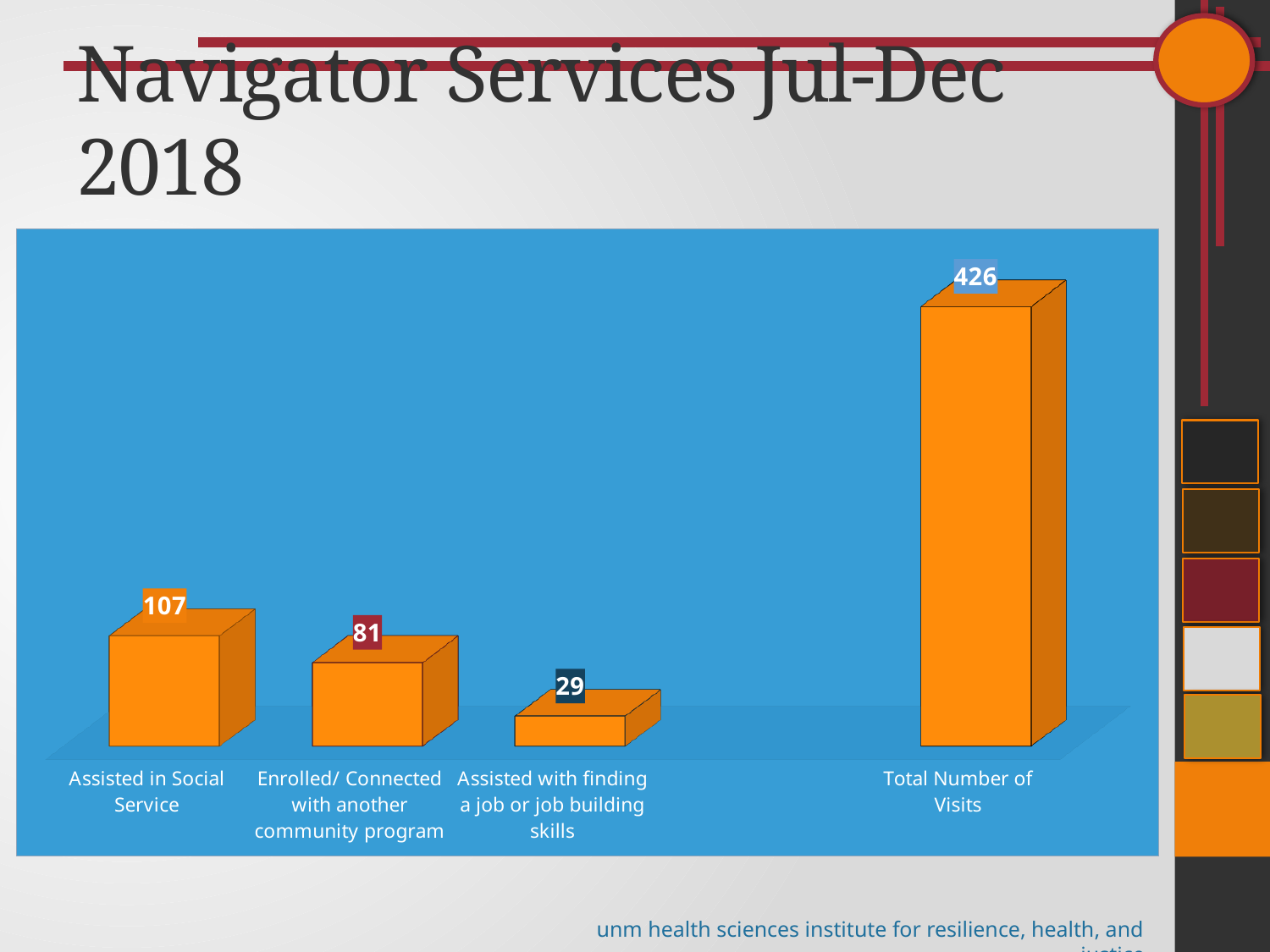
How many categories are shown in the chart? 4 What is the value for Enrolled/ Connected with another community program? 81 What is the value for Assisted in Social Service? 107 What is the difference between Assisted in Social Service and Enrolled/ Connected with another community program? 26 What kind of chart is shown on the slide? Bar chart What is the value for Assisted with finding a job or job building skills? 29 What is the difference between Total Number of Visits and Assisted in Social Service? 319 What is the value for Total Number of Visits? 426 Which is larger, Enrolled/ Connected with another community program or Assisted with finding a job or job building skills? Enrolled/ Connected with another community program What is the title of the slide containing the chart? Navigator Services Jul-Dec 2018 Which category has the highest value? Total Number of Visits Which category has the lowest value? Assisted with finding a job or job building skills